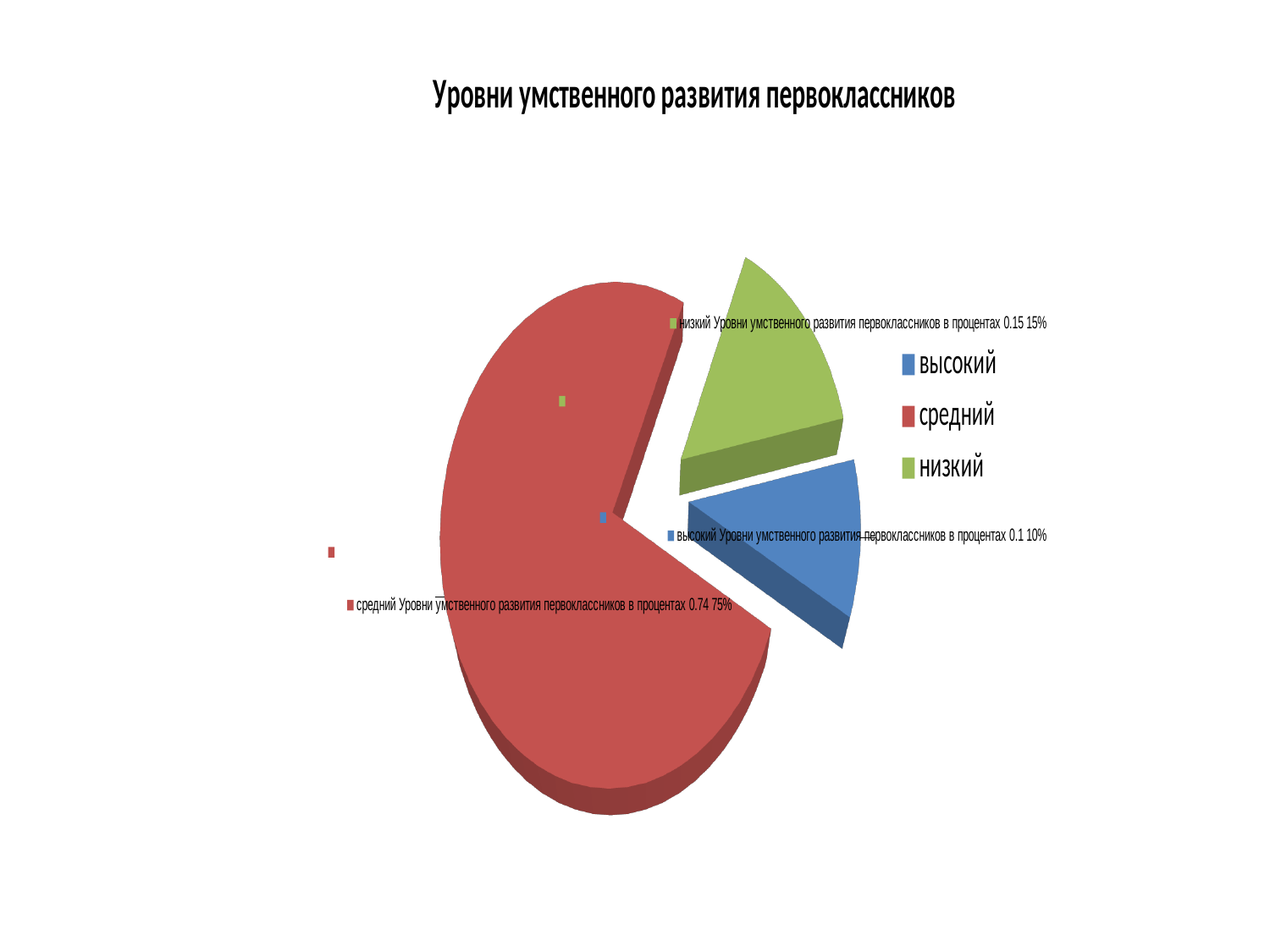
What value is printed on the data label for 'высокий'? 0.1 What value is printed on the data label for 'средний'? 0.74 How many slices does the pie chart have? 3 Which slice is larger, 'низкий' or 'высокий'? низкий What type of chart is shown on the slide? pie chart Which category has the smallest slice? высокий Which category has the largest slice? средний What percentage share does the 'средний' slice have? 75% What is the title of the chart? Уровни умственного развития первоклассников How many entries does the legend list? 3 What percentage share does the 'высокий' slice have? 10% What percentage share does the 'низкий' slice have? 15%